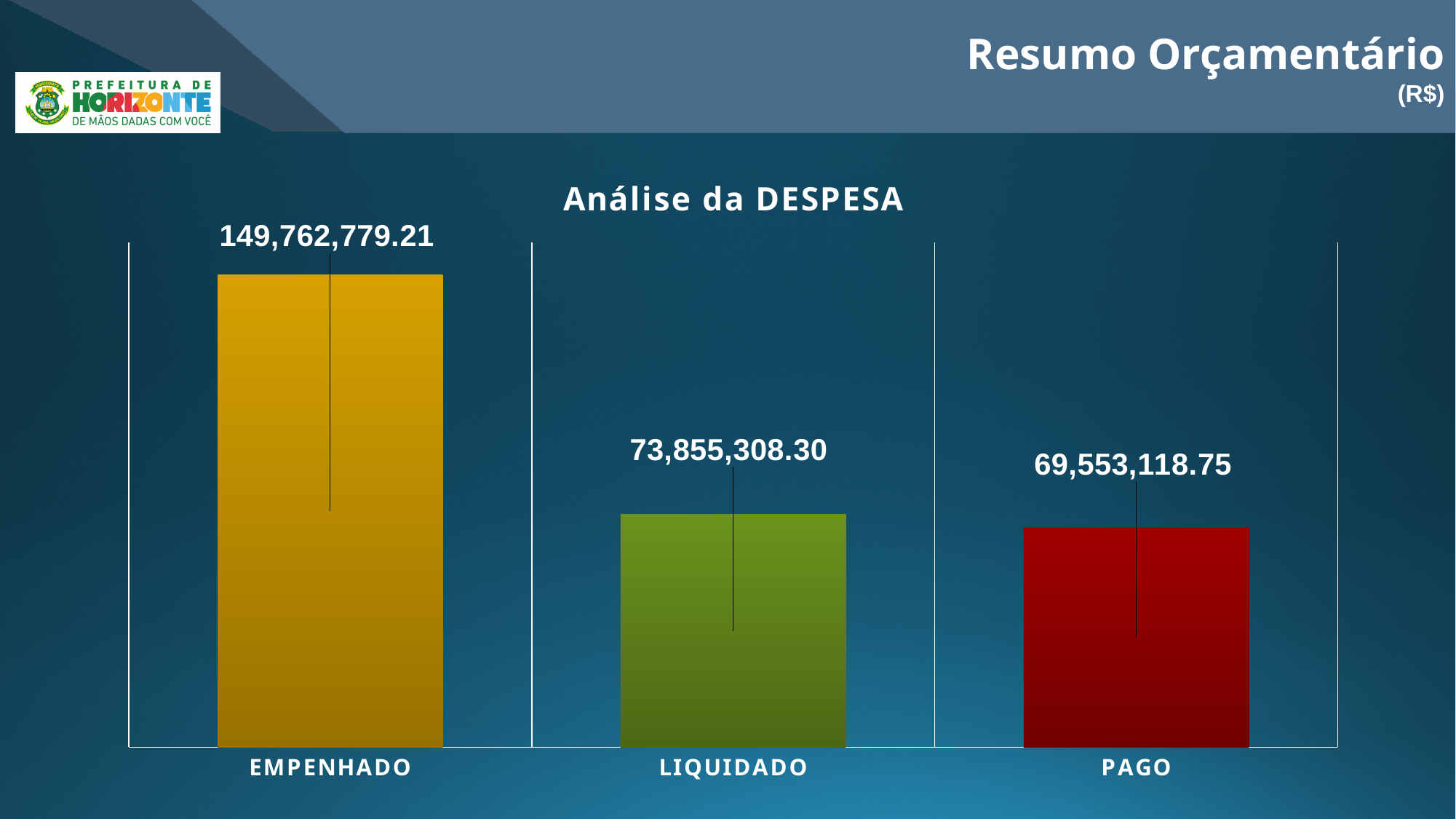
Which category has the lowest value? PAGO What is the value for LIQUIDADO? 73,855,308.30 Which is larger, the value for LIQUIDADO or the value for PAGO? LIQUIDADO What is the difference between the EMPENHADO and LIQUIDADO values? 75,907,470.91 What is the value for EMPENHADO? 149,762,779.21 Which category has the highest value? EMPENHADO What is the difference between the LIQUIDADO and PAGO values? 4,302,189.55 How many categories are shown in the chart? 3 What kind of chart is shown on the slide? Bar chart What is the title of the chart? Análise da DESPESA What is the difference between the EMPENHADO and PAGO values? 80,209,660.46 What is the value for PAGO? 69,553,118.75